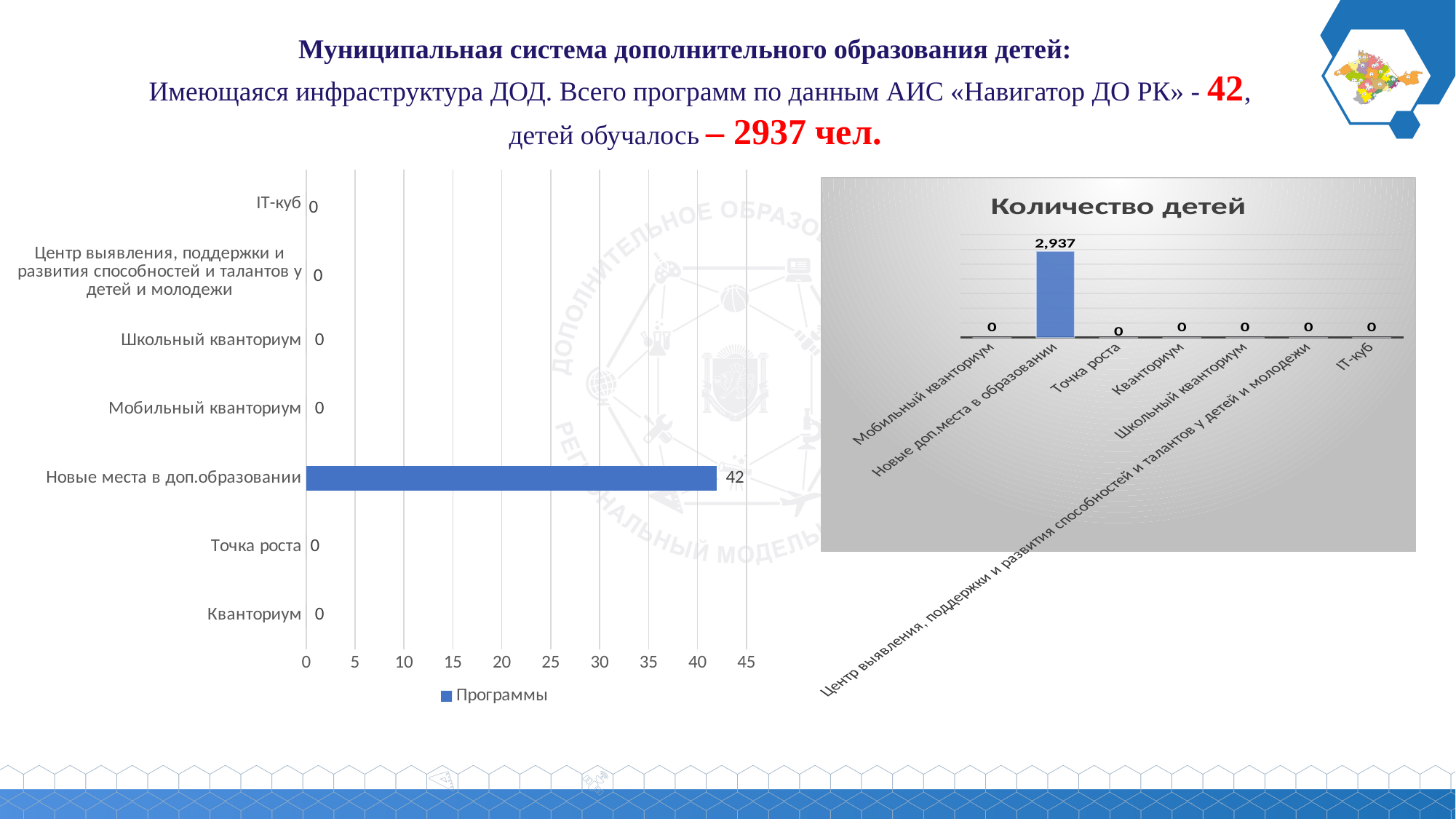
In the chart titled Количество детей, what is the value for Новые доп.места в образовании? 2,937 In the left chart (Программы), what is the value for Точка роста? 0 In the chart titled Количество детей, what is the value for IT-куб? 0 In the left chart (Программы), how many series does the legend list? 1 In the left chart (Программы), what is the value for Новые места в доп.образовании? 42 In the chart titled Количество детей, how many categories are shown? 7 In the left chart (Программы), what kind of chart is it? Bar chart In the left chart (Программы), is the value for Новые места в доп.образовании greater or less than 40? greater In the left chart (Программы), which category has the highest value? Новые места в доп.образовании In the chart titled Количество детей, which category has the highest value? Новые доп.места в образовании In the chart titled Количество детей, what is the difference between Новые доп.места в образовании and Кванториум? 2,937 In the left chart (Программы), how many categories are shown? 7